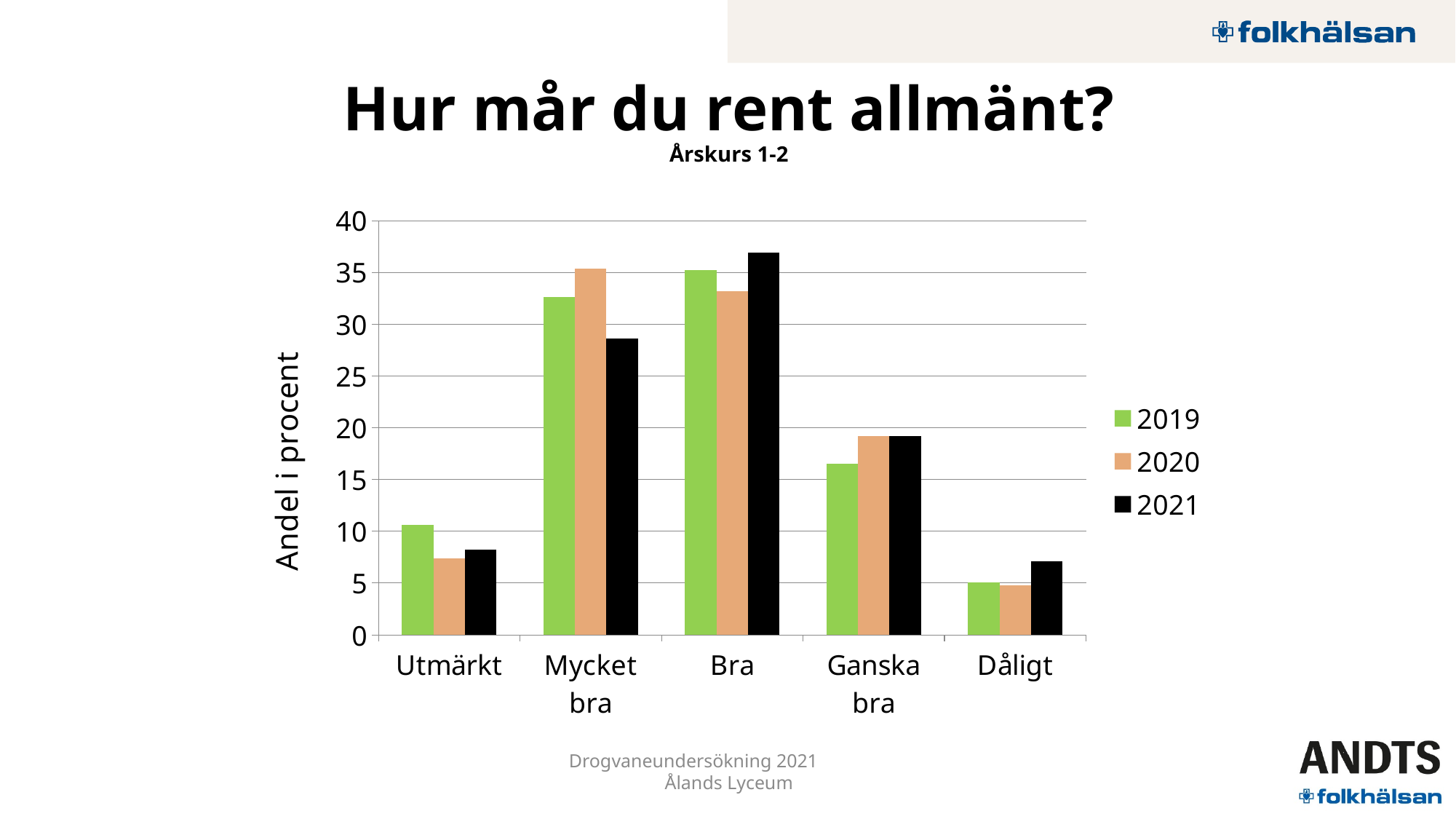
How many categories are shown on the x axis? 5 What is the title of the y axis? Andel i procent How many series does the legend list? 3 Is the 2021 value for Mycket bra greater or less than 30? less What kind of chart is shown on the slide? Bar chart Which category has the highest value for the 2021 series? Bra For Utmärkt, which series has the larger value, 2019 or 2020? 2019 Is the 2021 value for Bra greater or less than 35? greater Which category has the highest value for the 2020 series? Mycket bra Which category has the lowest value for the 2019 series? Dåligt Is the 2019 value for Ganska bra greater or less than 20? less For Mycket bra, which series has the larger value, 2019 or 2021? 2019